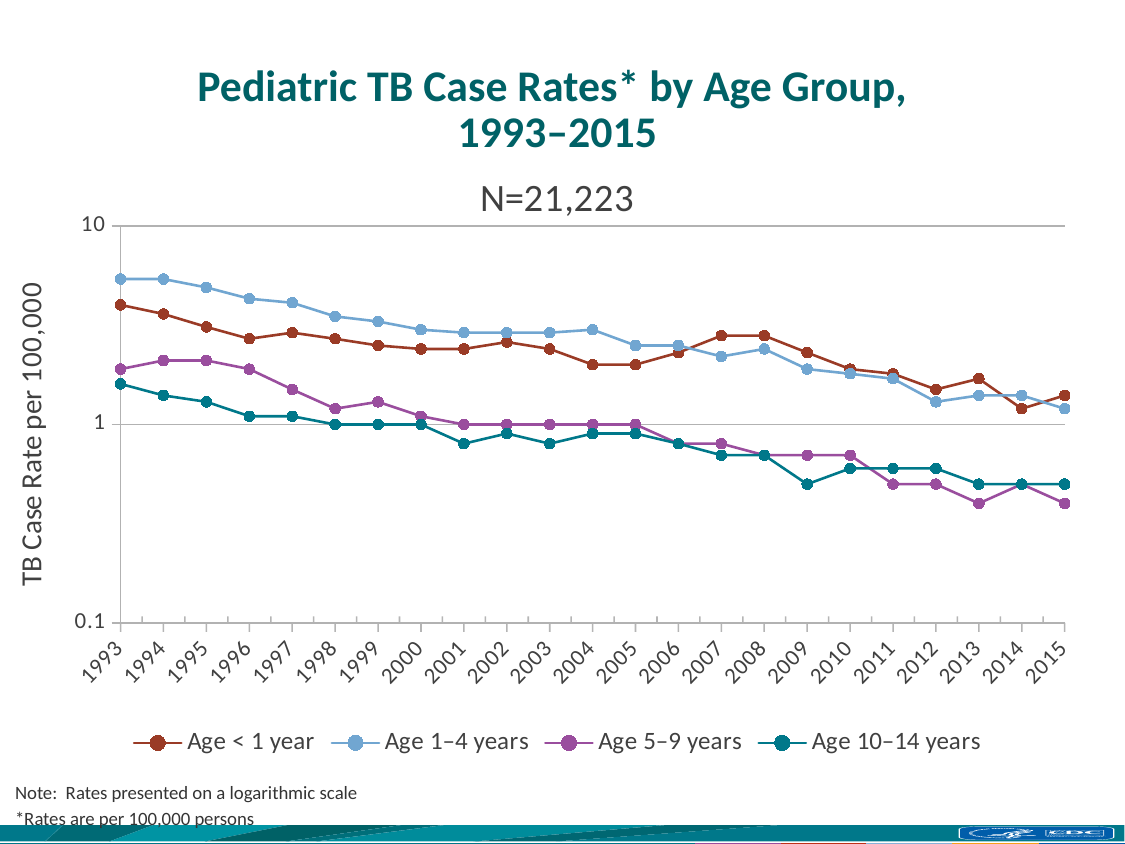
In 1993, which is larger: the rate for Age 1–4 years or the rate for Age 10–14 years? Age 1–4 years What is the N value shown above the chart? N=21,223 Is the value for Age 1–4 years in 1993 greater or less than 1? greater Which age group has the highest TB case rate in 1993? Age 1–4 years How many series does the legend list? 4 Does the TB case rate for Age 1–4 years generally rise or fall from 1993 to 2015? fall Which age group has the lowest TB case rate in 2015? Age 5–9 years How many years are plotted along the x axis? 23 Is the value for Age 5–9 years in 2015 greater or less than 1? less What kind of chart is shown on the slide? line chart Which age group has the lowest TB case rate in 1993? Age 10–14 years Is the value for Age 10–14 years in 2013 greater or less than 1? less